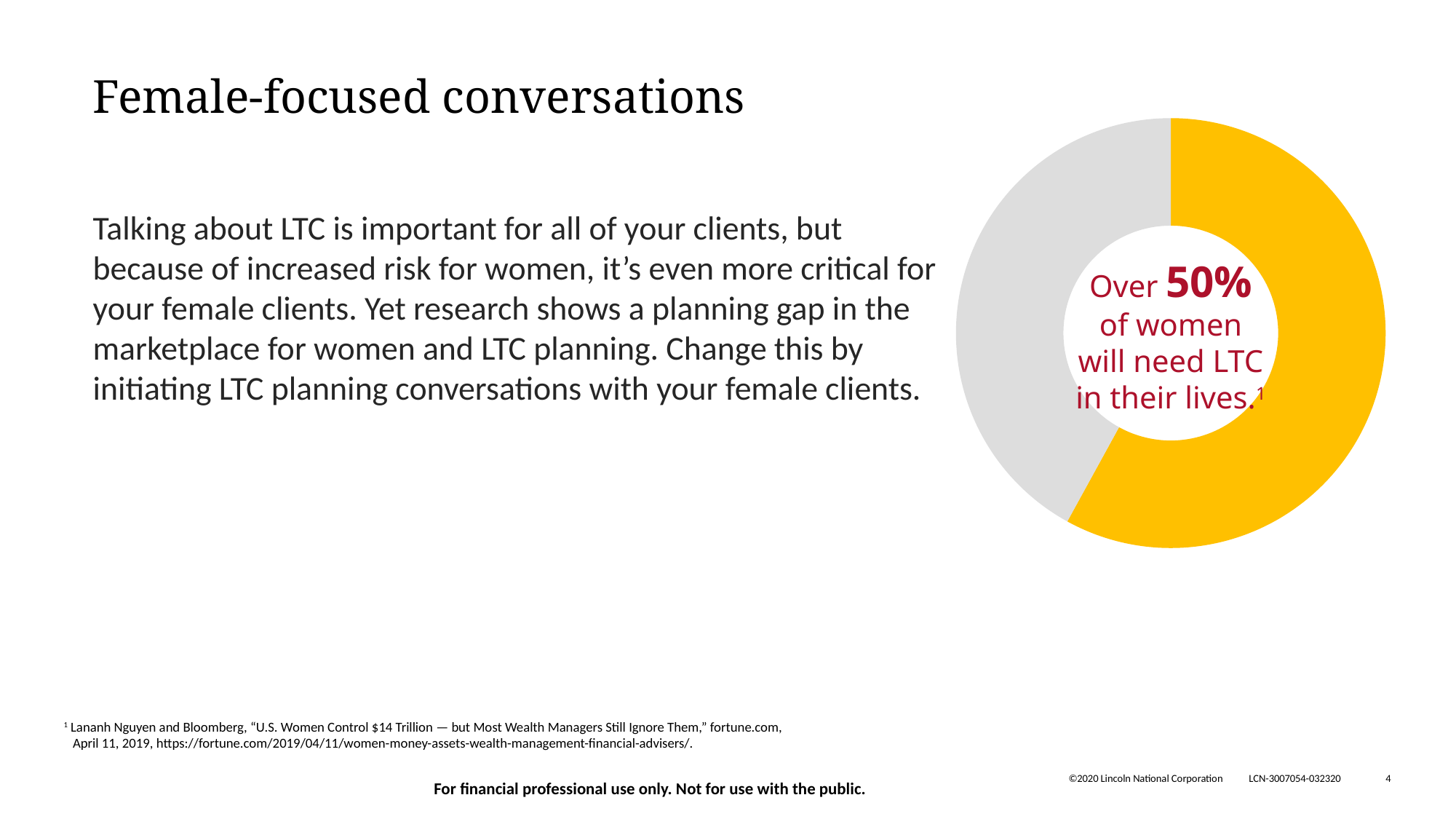
What share of women does the text in the centre of the donut chart say will need LTC in their lives? Over 50% Which slice of the donut chart is larger, the yellow one or the gray one? The yellow one Is the gray slice of the donut chart greater or less than 50% of the whole? less What kind of chart is shown on the slide? Pie chart (donut) How many slices does the donut chart have? 2 What text is printed in the centre of the donut chart? Over 50% of women will need LTC in their lives. Is the yellow slice of the donut chart greater or less than 50% of the whole? greater What colour is the larger slice of the donut chart? Yellow